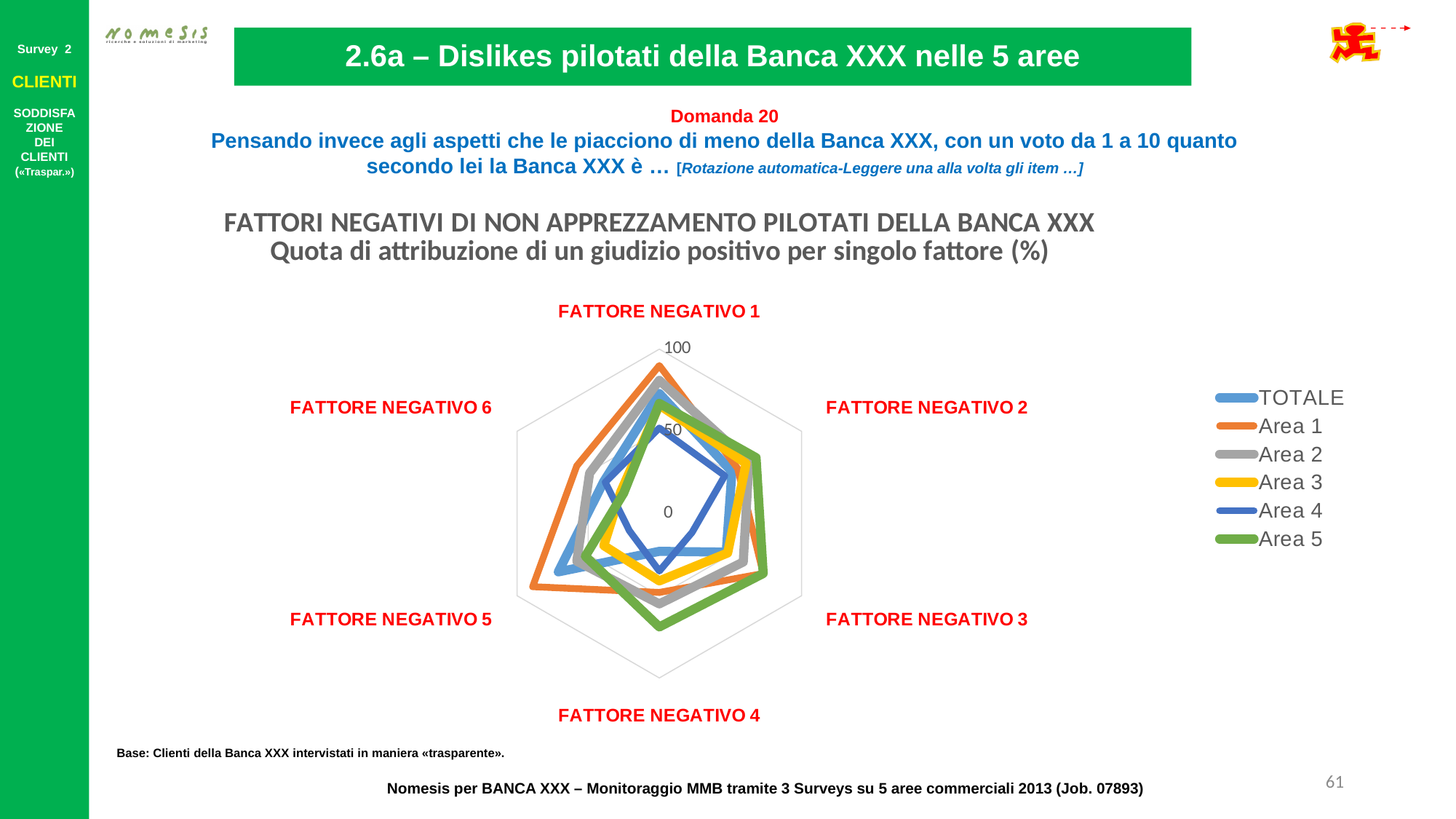
How many factors (categories) are plotted on the radar chart? 6 Is the value of Area 1 for FATTORE NEGATIVO 1 greater or less than 50? greater Which series has the highest value for FATTORE NEGATIVO 1? Area 1 What kind of chart is shown on the slide? Radar chart Which series has the lowest value for FATTORE NEGATIVO 4? TOTALE How many series does the legend list? 6 Is the value of Area 4 for FATTORE NEGATIVO 6 greater or less than 50? less Is the value of Area 4 for FATTORE NEGATIVO 4 greater or less than 50? less Which series is listed first in the legend? TOTALE What is the highest value shown on the radar chart's axis scale? 100 For FATTORE NEGATIVO 5, which is larger: the value of Area 1 or the value of Area 4? Area 1